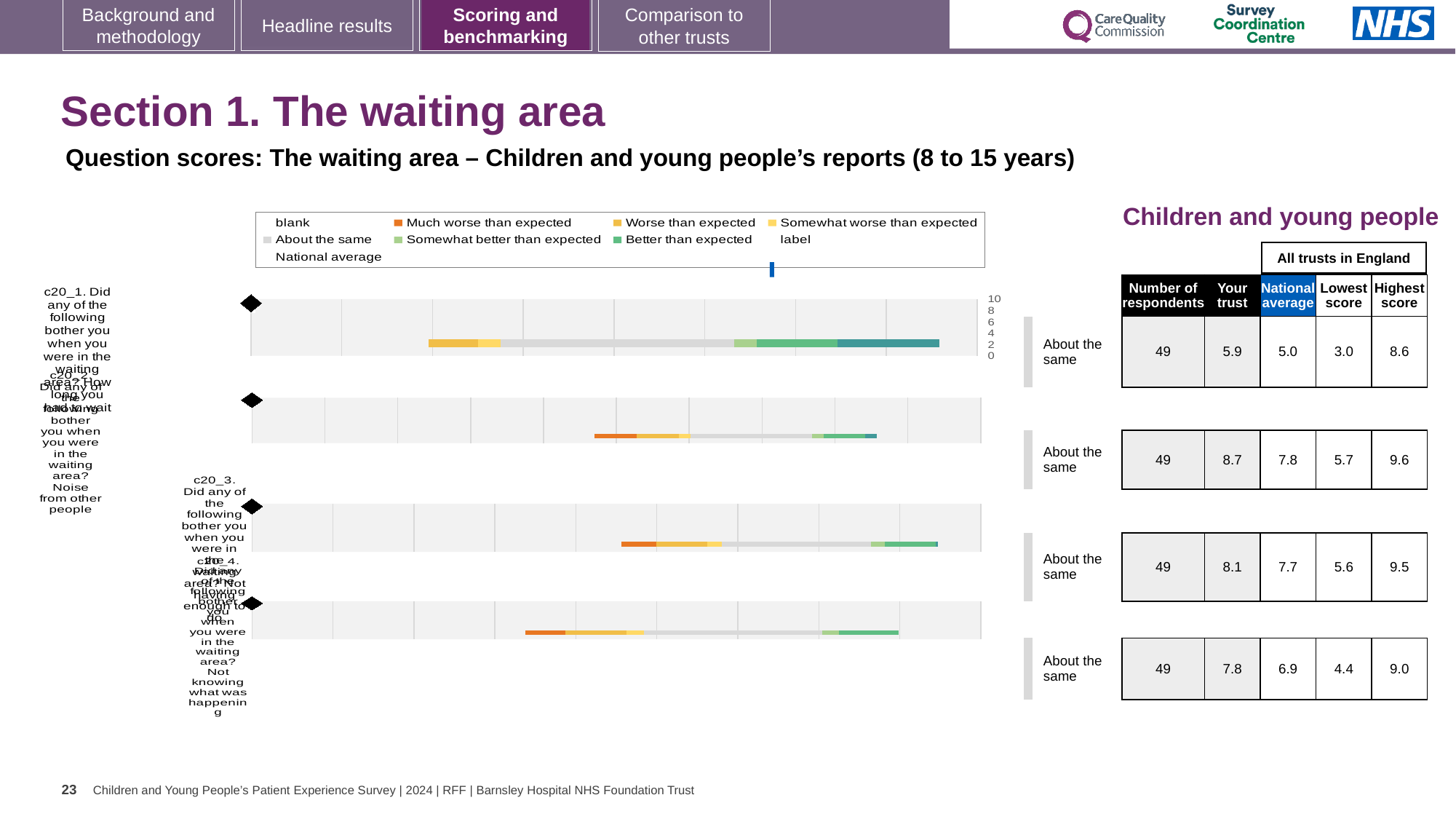
Which question has the lowest 'Your trust' score? c20_1 (noise from other people) Which is larger: the trust's score for c20_3 or for c20_4? c20_3 How many respondents answered question c20_1? 49 What is the lowest score among all trusts in England for question c20_3 (not having enough to do)? 5.6 What kind of chart is used to show the question scores on this slide? Bar chart What is the 'Your trust' score for question c20_1 (noise from other people)? 5.9 What rating category is shown next to each of the four question charts? About the same How many question charts (rows) are shown on the slide? 4 What is the national average for question c20_2 (how long you had to wait)? 7.8 What is the difference between the trust's score and the national average for question c20_2? 0.9 What is the highest score among all trusts in England for question c20_4 (not knowing what was happening)? 9.0 Which question has the highest 'Your trust' score? c20_2 (how long you had to wait)